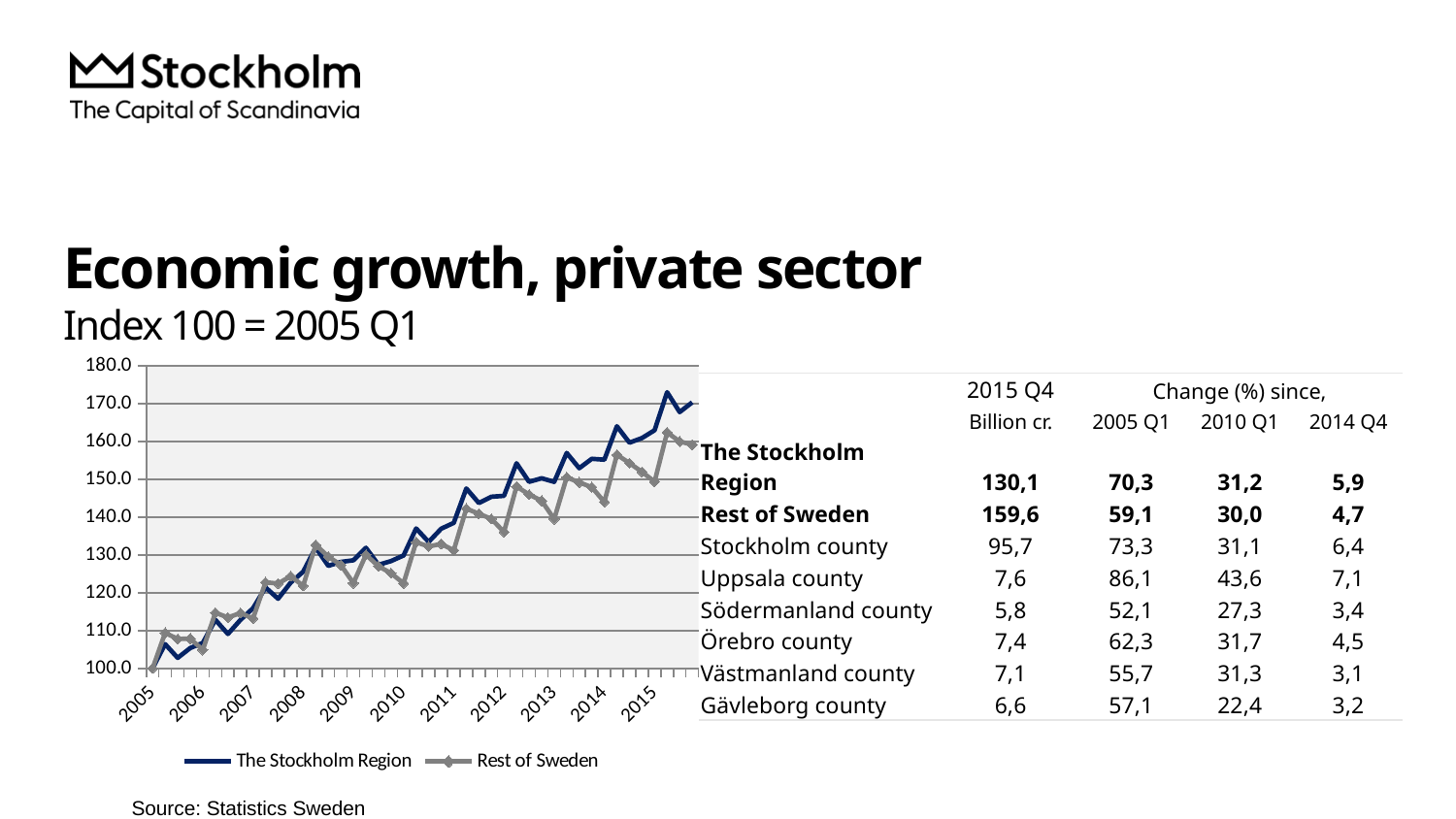
What kind of chart is shown on the slide? line chart How many year labels are shown on the x axis of the chart? 11 Is the value for The Stockholm Region in 2008 greater or less than 140? less Is the value for The Stockholm Region at the end of 2015 greater or less than 160? greater At the end of 2015, which series is higher, The Stockholm Region or Rest of Sweden? The Stockholm Region How many series does the chart legend list? 2 What are the two series named in the chart legend? The Stockholm Region and Rest of Sweden Is the value for Rest of Sweden at the end of 2015 greater or less than 170? less What is the index value for both series at the start of the chart (2005 Q1)? 100.0 Do the values for The Stockholm Region generally rise or fall from 2005 to 2015? rise What is the highest value shown on the chart's y axis? 180.0